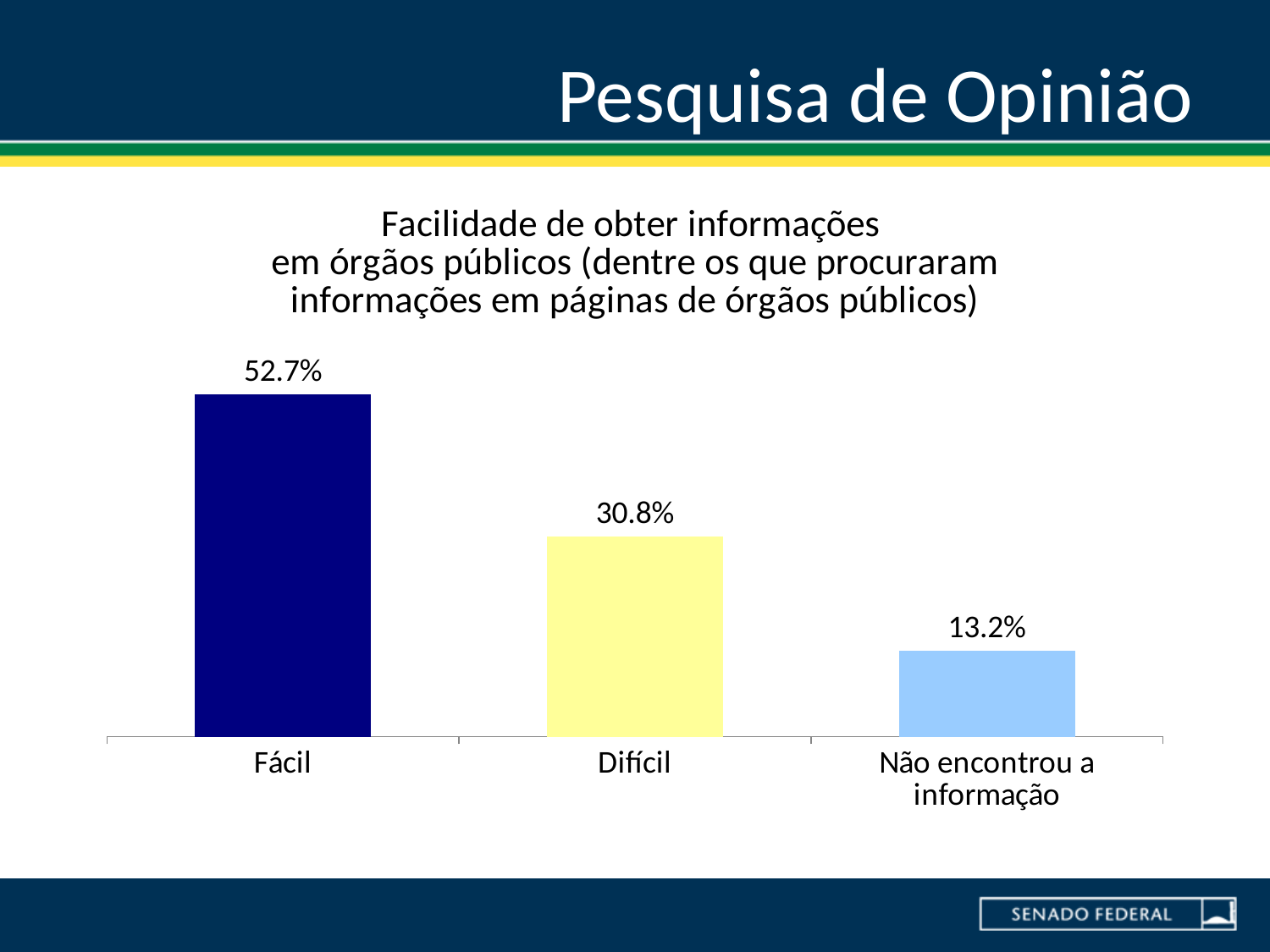
What is the difference between the values for Fácil and Difícil? 21.9% What kind of chart is shown on the slide? Bar chart Do the values rise or fall from left to right across the categories? Fall Which category has the highest value? Fácil What is the difference between the values for Difícil and Não encontrou a informação? 17.6% How many categories are shown in the chart? 3 What is the value for Não encontrou a informação? 13.2% What is the value for Difícil? 30.8% What colour is the bar for Fácil? Dark blue Which category has the lowest value? Não encontrou a informação Which is larger, the value for Difícil or the value for Não encontrou a informação? Difícil What is the value for Fácil? 52.7%